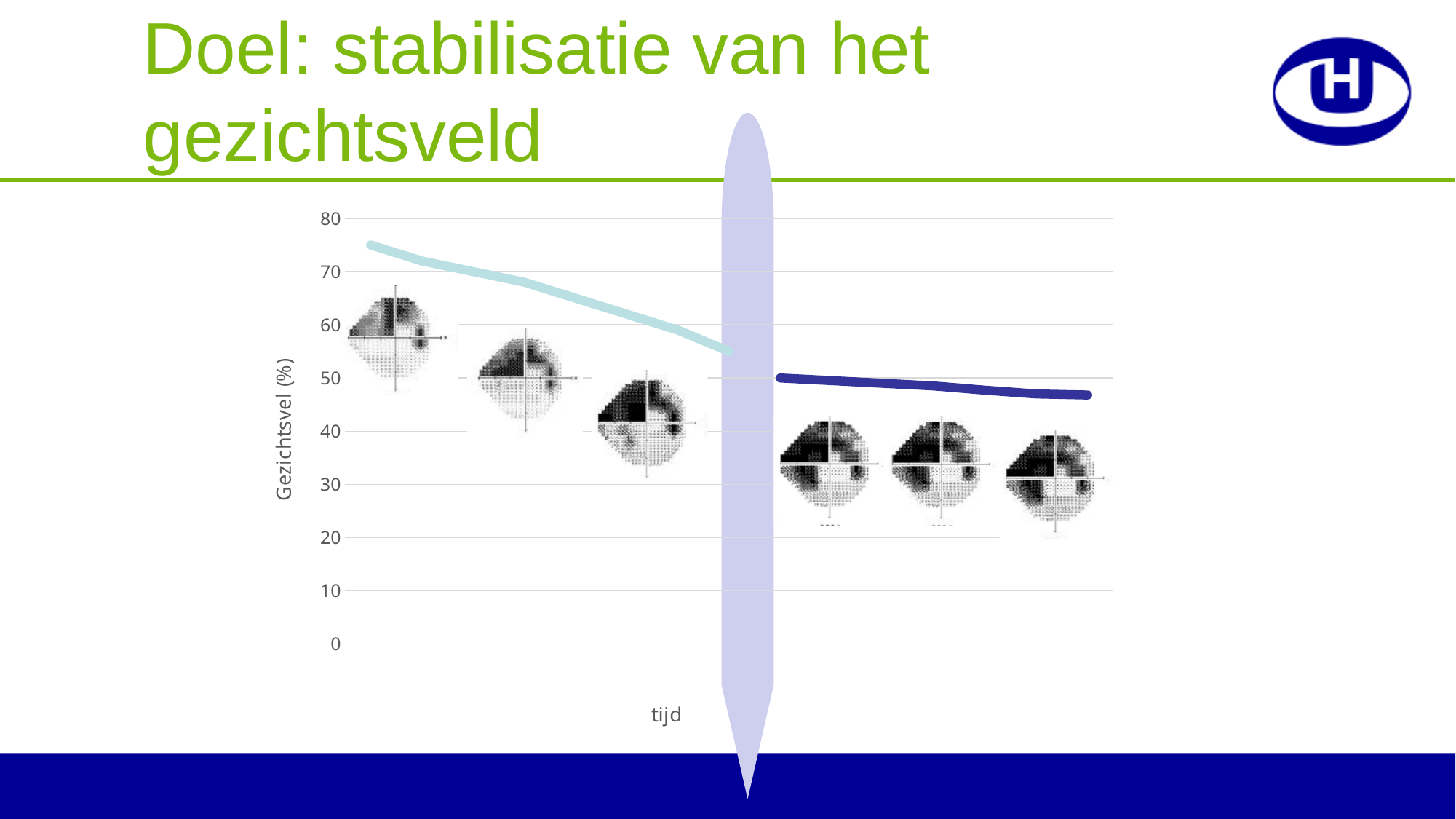
What is the label on the vertical axis of the chart? Gezichtsvel (%) What kind of chart is shown on the slide? line chart How many lines are plotted on the chart? 2 Which line has the higher values, the light blue line or the dark blue line? the light blue line Does the dark blue line rise or fall from left to right? fall What is the highest tick value shown on the vertical axis? 80 Does the light blue line rise or fall from left to right? fall What is the label on the horizontal axis of the chart? tijd Is the starting value of the dark blue line greater or less than 60? less Is the starting value of the light blue line greater or less than 70? greater Is the end value of the dark blue line greater or less than 40? greater